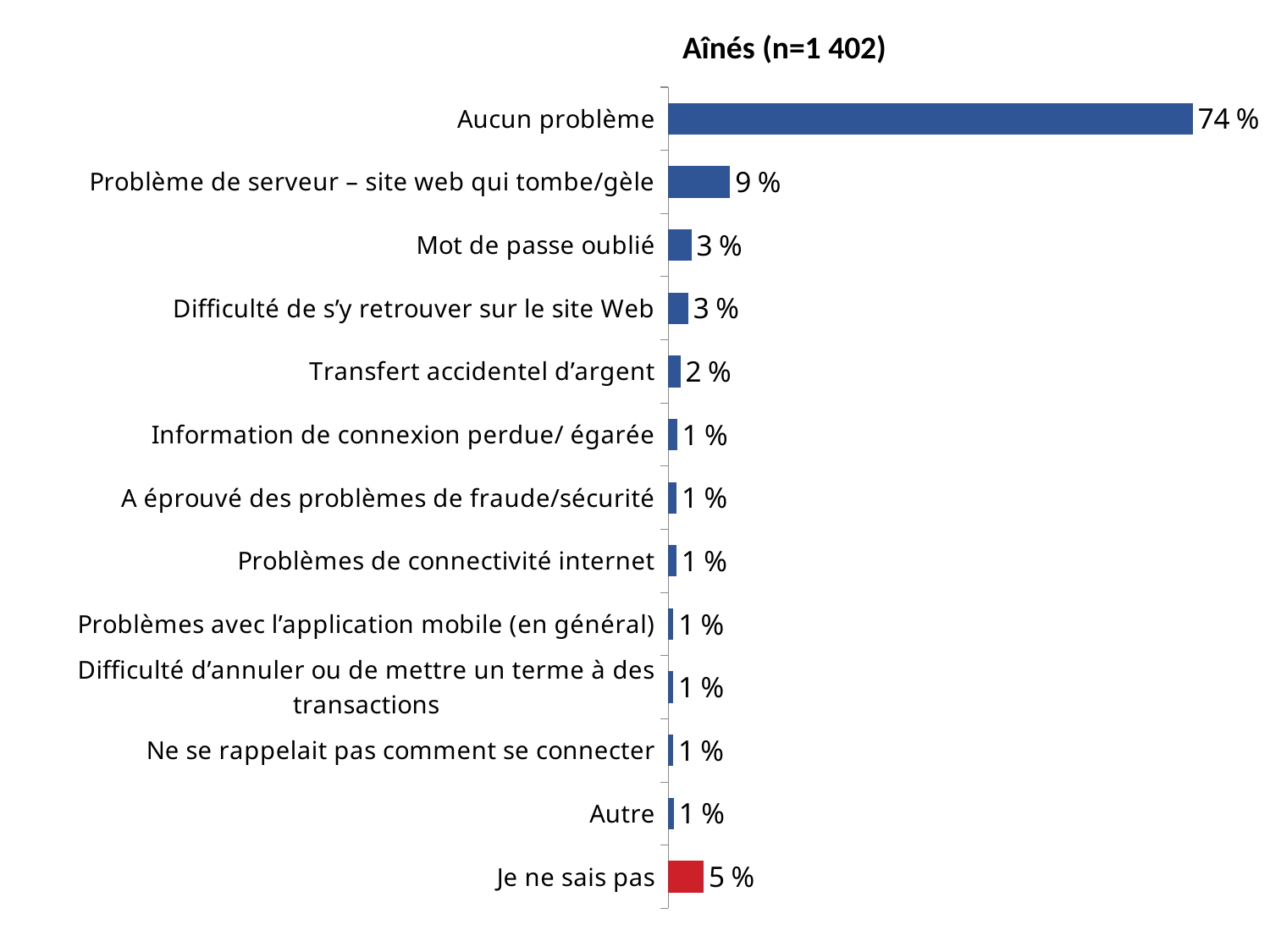
What is the difference between "Aucun problème" and "Problème de serveur – site web qui tombe/gèle"? 65 % What is the title of the chart? Aînés (n=1 402) What kind of chart is this? Bar chart What is the difference between "Je ne sais pas" and "Mot de passe oublié"? 2 % Which is larger, "Je ne sais pas" or "Problème de serveur – site web qui tombe/gèle"? Problème de serveur – site web qui tombe/gèle What is the value for "Transfert accidentel d'argent"? 2 % What is the value for "Problème de serveur – site web qui tombe/gèle"? 9 % How many categories are shown in the chart? 13 Which category has the highest value? Aucun problème Which category's bar is coloured red rather than blue? Je ne sais pas What is the value for "Je ne sais pas"? 5 % What is the value for "Aucun problème"? 74 %